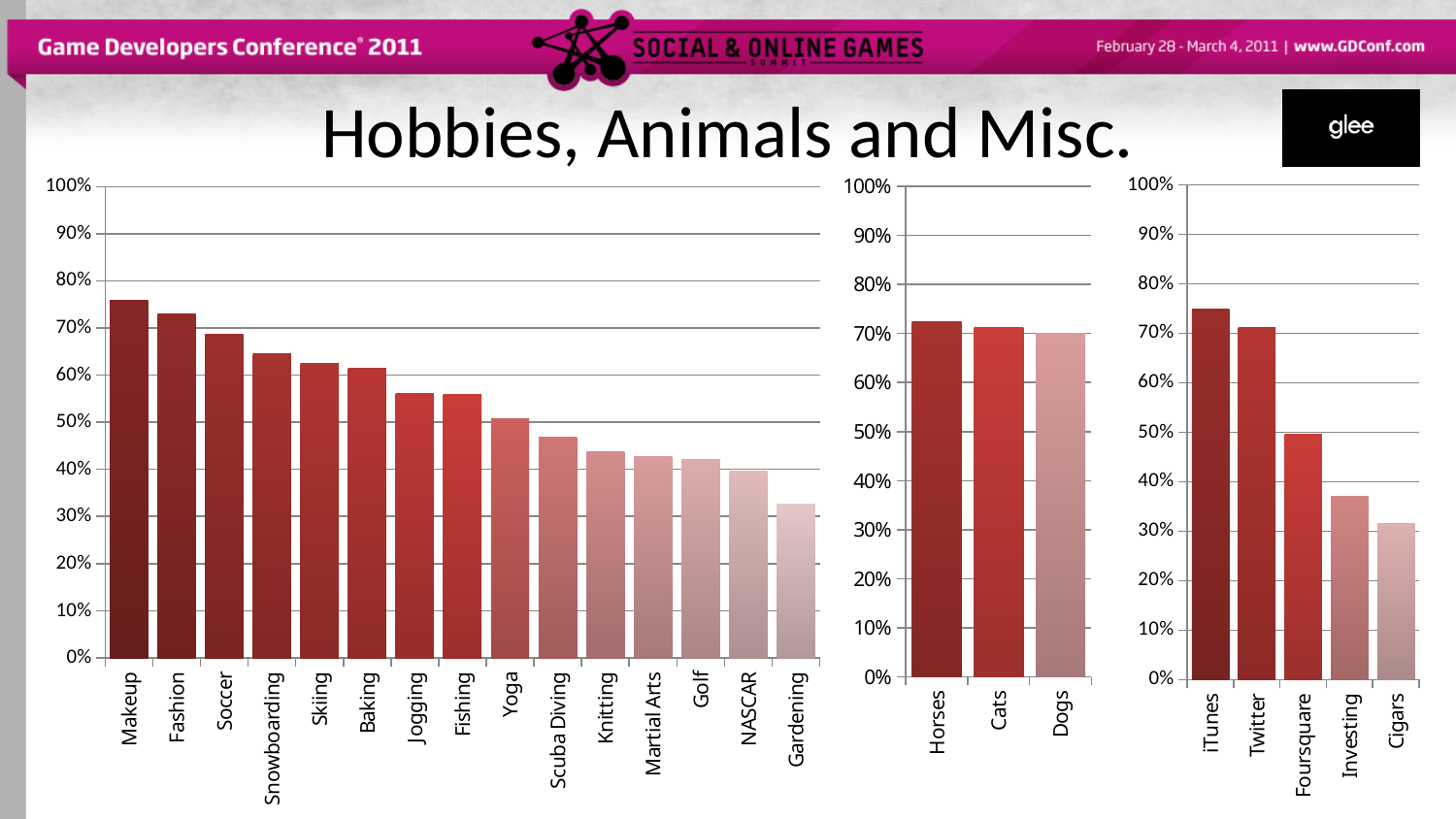
What kind of chart is the right chart? bar chart In the left chart, which is larger, the value for Soccer or the value for Golf? Soccer In the left chart, which category has the lowest value? Gardening How many categories are shown in the middle chart? 3 In the right chart, which category has the lowest value? Cigars In the left chart, which category has the highest value? Makeup In the left chart, do the values rise or fall from left to right along the x axis? fall In the middle chart, is the value for Horses greater or less than 60%? greater How many categories are shown in the left chart? 15 In the left chart, is the value for Makeup greater or less than 70%? greater In the left chart, is the value for Gardening greater or less than 40%? less In the right chart, which category has the highest value? iTunes